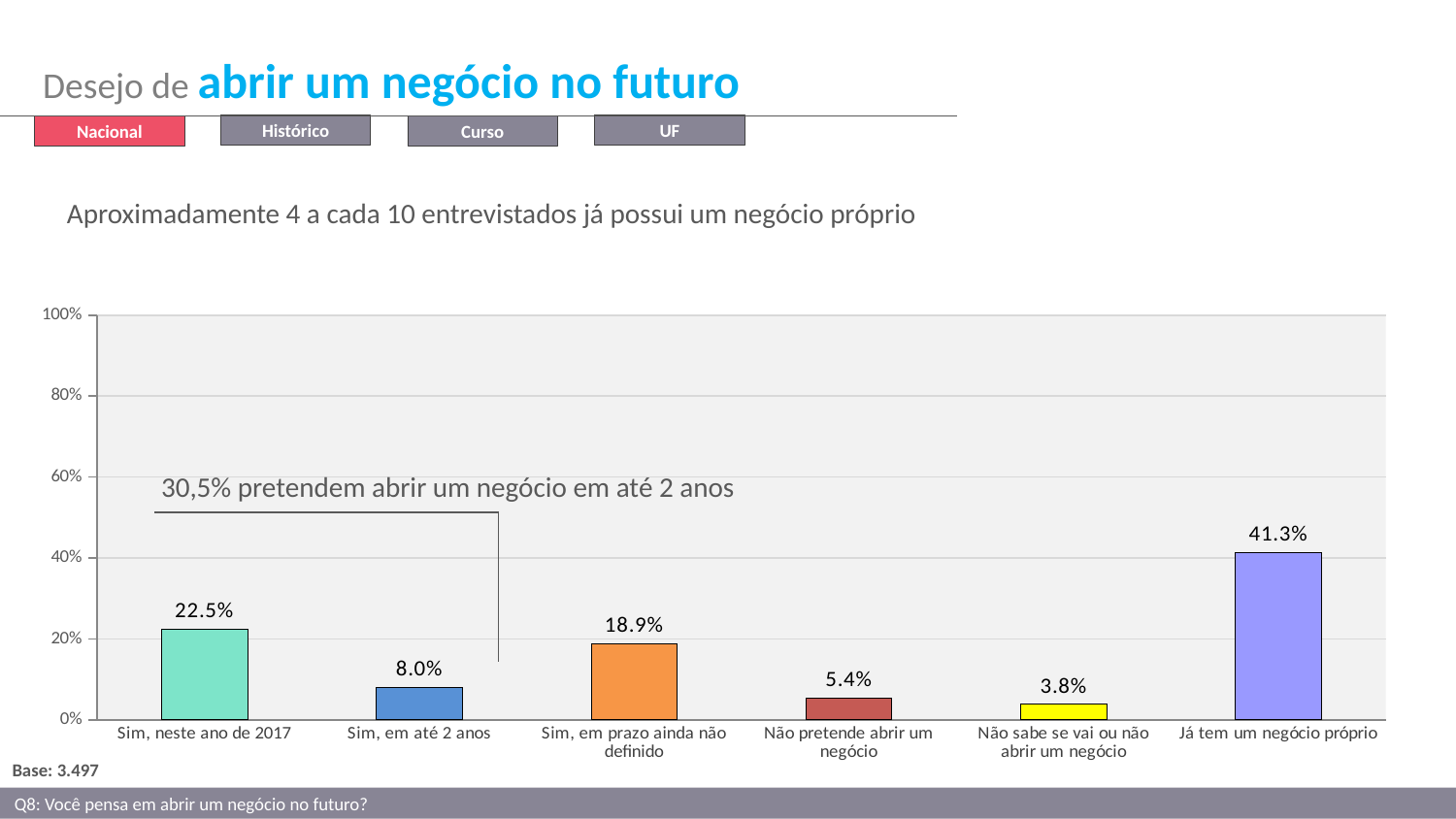
What is the value for "Não sabe se vai ou não abrir um negócio"? 3.8% What is the base (sample size) stated below the chart? 3.497 Which is larger: "Sim, em prazo ainda não definido" or "Não pretende abrir um negócio"? Sim, em prazo ainda não definido What is the difference between "Já tem um negócio próprio" and "Sim, neste ano de 2017"? 18.8% Which category has the highest value? Já tem um negócio próprio What kind of chart is shown on the slide? bar chart What is the value for "Já tem um negócio próprio"? 41.3% What is the value for "Sim, em até 2 anos"? 8.0% Which category has the lowest value? Não sabe se vai ou não abrir um negócio What is the value for "Sim, neste ano de 2017"? 22.5% How many categories are shown on the x axis? 6 Is the value for "Já tem um negócio próprio" greater or less than 40%? greater